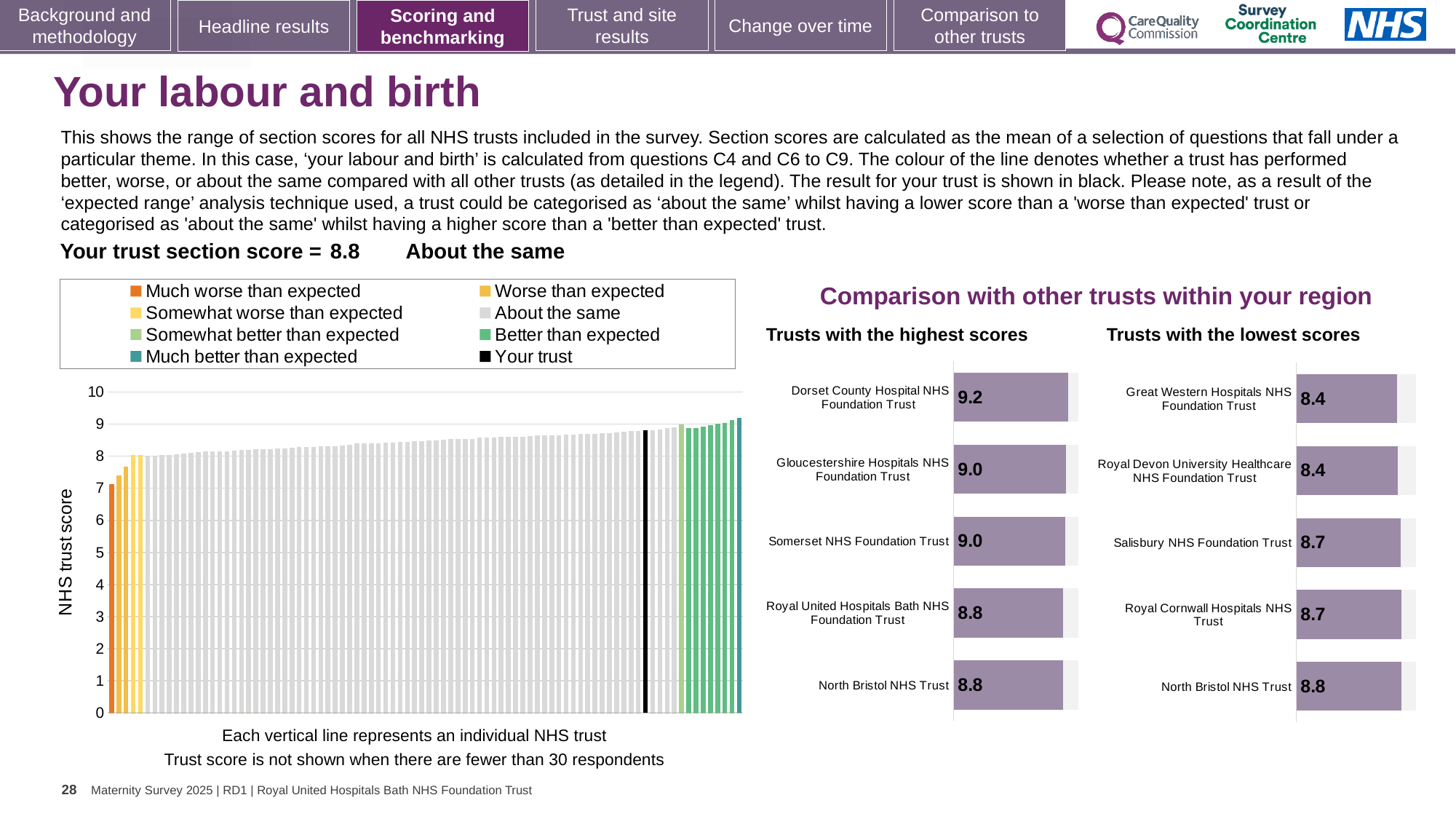
In the 'Trusts with the highest scores' chart, which trust has the highest score? Dorset County Hospital NHS Foundation Trust How many entries does the legend above the large 'NHS trust score' chart list? 8 How many trusts are listed in the 'Trusts with the highest scores' chart? 5 Which is larger: the score for Dorset County Hospital NHS Foundation Trust in the 'highest scores' chart or the score for Salisbury NHS Foundation Trust in the 'lowest scores' chart? Dorset County Hospital NHS Foundation Trust In the 'Trusts with the lowest scores' chart, what is the score for Salisbury NHS Foundation Trust? 8.7 In the large 'NHS trust score' chart on the left, is the value of the black bar (your trust) greater or less than 8? greater In the 'Trusts with the lowest scores' chart, which trust has the highest score? North Bristol NHS Trust In the 'Trusts with the highest scores' chart, what is the score for Dorset County Hospital NHS Foundation Trust? 9.2 In the 'Trusts with the lowest scores' chart, what is the difference between the scores of North Bristol NHS Trust and Great Western Hospitals NHS Foundation Trust? 0.4 What kind of chart is the large chart on the left with the y-axis labelled 'NHS trust score'? bar chart In the large 'NHS trust score' chart on the left, is the value of the leftmost (orange) bar greater or less than 8? less In the 'Trusts with the highest scores' chart, what is the difference between the scores of Dorset County Hospital NHS Foundation Trust and North Bristol NHS Trust? 0.4